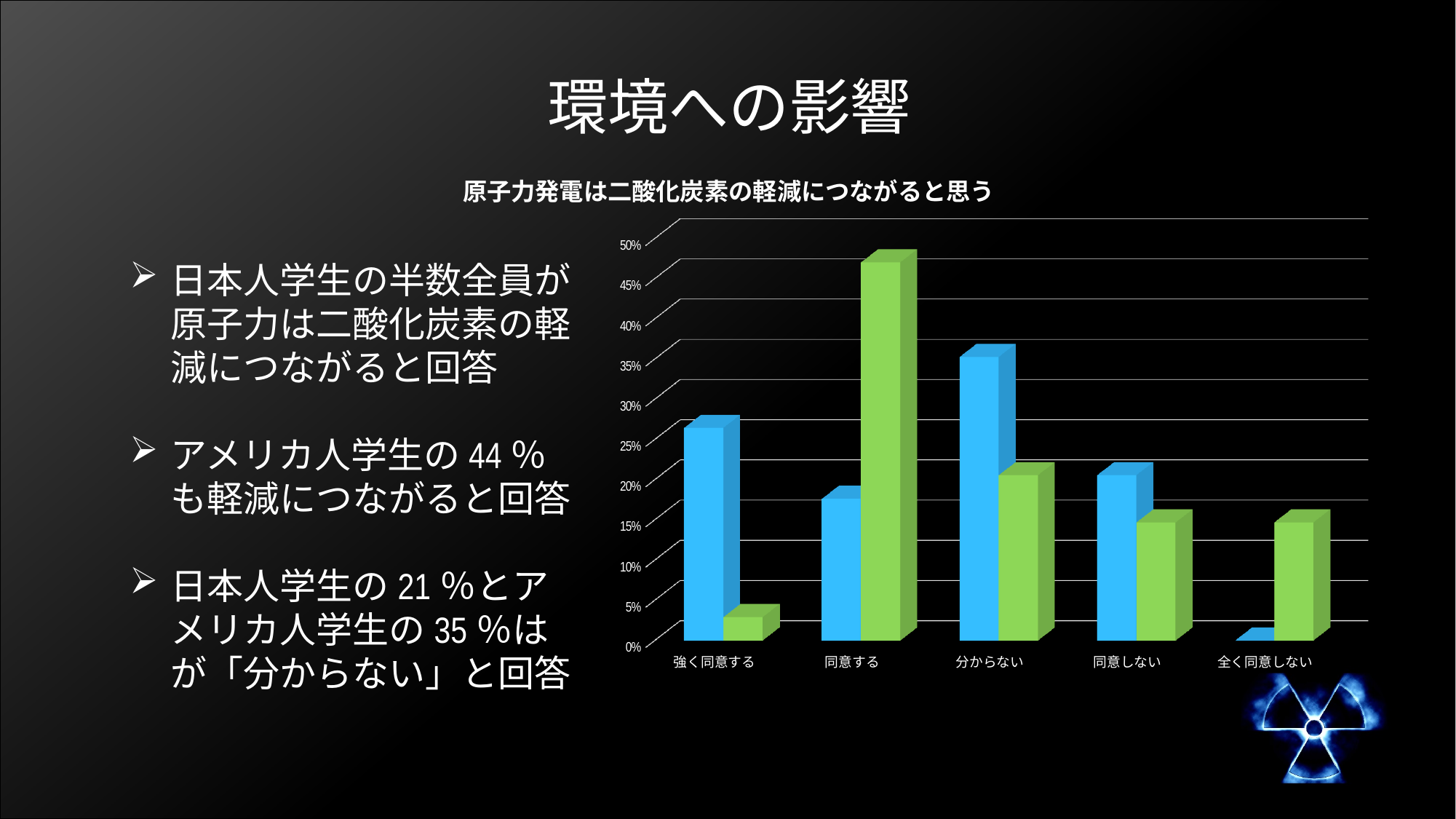
Which category has the tallest blue bar? 分からない For 強く同意する, which bar is taller, the blue one or the green one? The blue one How many categories are shown on the x axis of the chart? 5 Is the blue bar for 強く同意する greater or less than 20%? greater Which category has the tallest green bar? 同意する What kind of chart is shown on the slide? Bar chart Which category has the shortest blue bar? 全く同意しない What is the title of the chart? 原子力発電は二酸化炭素の軽減につながると思う Is the green bar for 同意しない greater or less than 20%? less For 全く同意しない, which bar is taller, the blue one or the green one? The green one Which category has the shortest green bar? 強く同意する Is the green bar for 同意する greater or less than 40%? greater